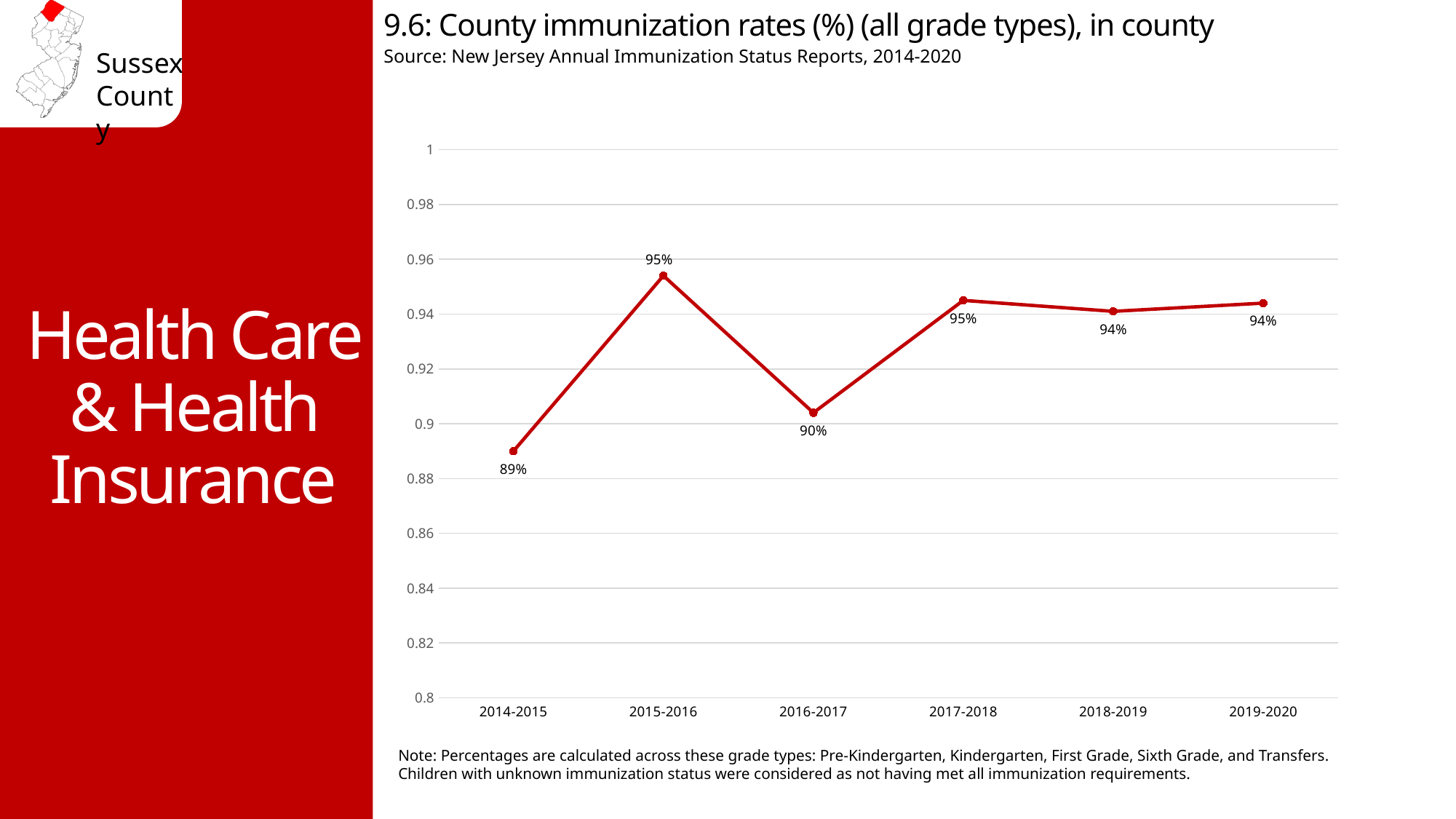
What type of chart is shown on the slide? Line chart What is the source cited for the chart data? New Jersey Annual Immunization Status Reports, 2014-2020 Does the immunization rate rise or fall from 2015-2016 to 2016-2017? Fall How many school years are plotted on the chart? 6 Is the value for 2014-2015 greater or less than 0.9? less What is the difference between the immunization rate in 2015-2016 and in 2014-2015? 6 percentage points What is the title of the chart? 9.6: County immunization rates (%) (all grade types), in county What is the county immunization rate for 2016-2017? 90% What is the county immunization rate for 2014-2015? 89% What is the county immunization rate for 2019-2020? 94% Which has a higher immunization rate, 2016-2017 or 2017-2018? 2017-2018 Which school year has the lowest immunization rate? 2014-2015